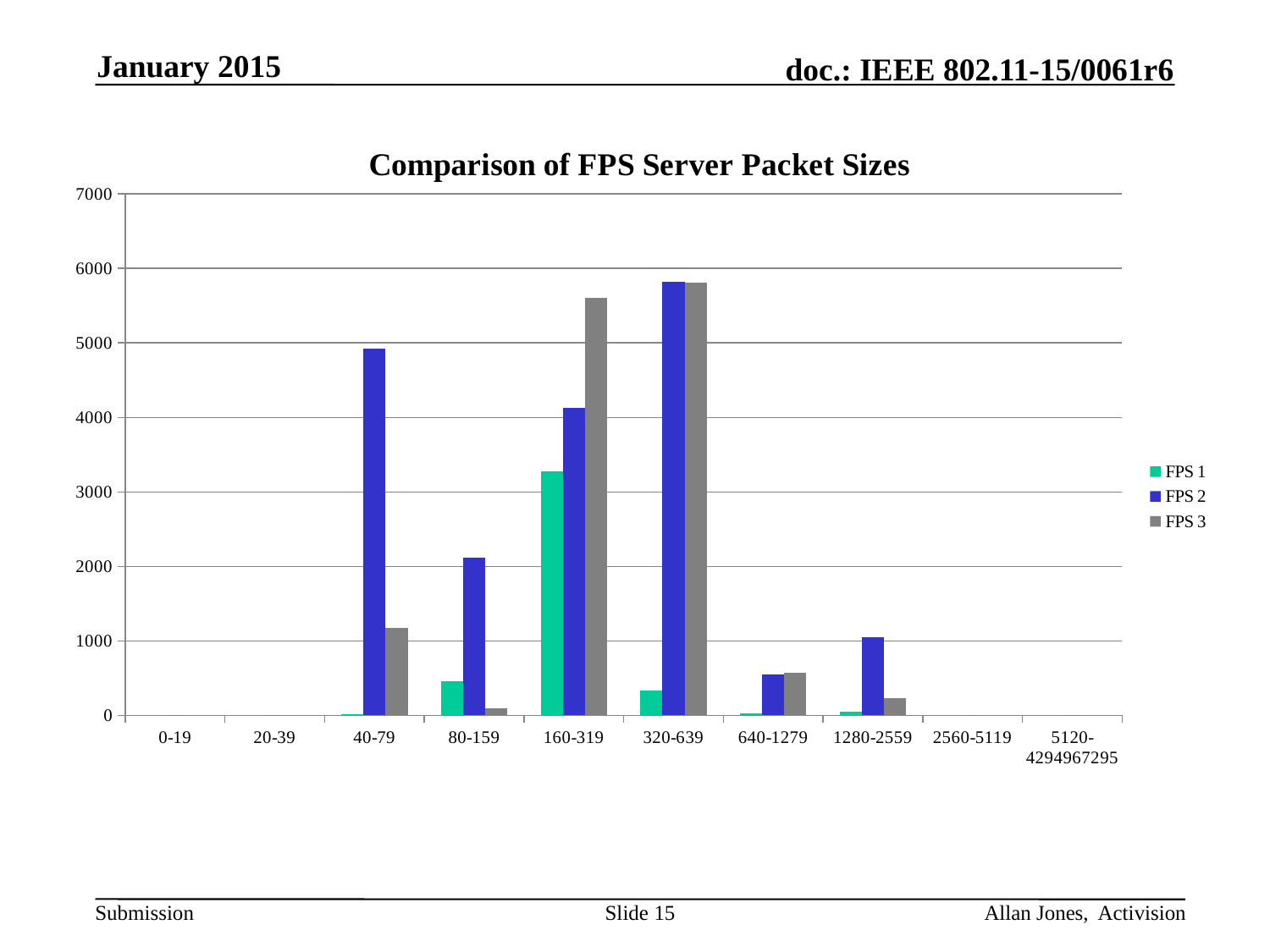
What kind of chart is shown on the slide? bar chart Is the value for FPS 3 in the 40-79 category greater or less than 2000? less How many packet size categories are shown on the x axis? 10 Is the value for FPS 2 in the 40-79 category greater or less than 4000? greater How many series does the legend list? 3 Is the value for FPS 3 in the 160-319 category greater or less than 5000? greater Which packet size category has the highest value for FPS 1? 160-319 What is the title of the chart? Comparison of FPS Server Packet Sizes In the 40-79 category, which is larger, FPS 2 or FPS 3? FPS 2 In the 160-319 category, which is larger, FPS 1 or FPS 3? FPS 3 Which packet size category has the highest value for FPS 2? 320-639